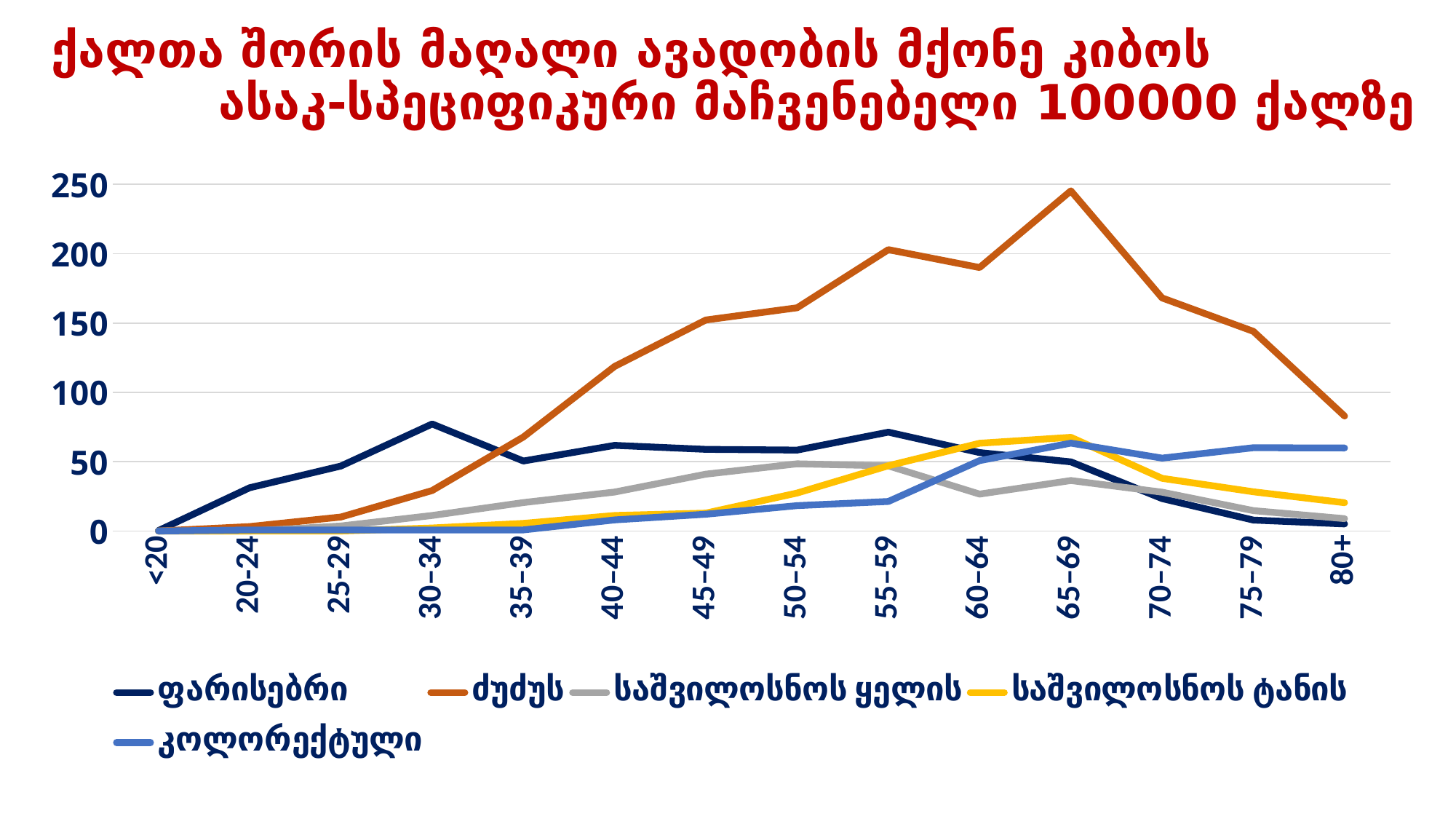
At 80+, which series has the larger value: კოლორექტული or ფარისებრი? კოლორექტული How many series does the legend list? 5 What kind of chart is shown on the slide? line chart In which age group does the ძუძუს series reach its highest value? 65-69 How many age groups are shown along the x axis? 14 Is the value of the ფარისებრი series at 30-34 greater or less than 50? greater Is the value of the კოლორექტული series at 80+ greater or less than 50? greater Is the value of the ძუძუს series at 80+ greater or less than 100? less Does the ძუძუს series rise or fall from 65-69 to 80+? fall At 30-34, which series has the larger value: ფარისებრი or ძუძუს? ფარისებრი Which series is drawn in orange? ძუძუს